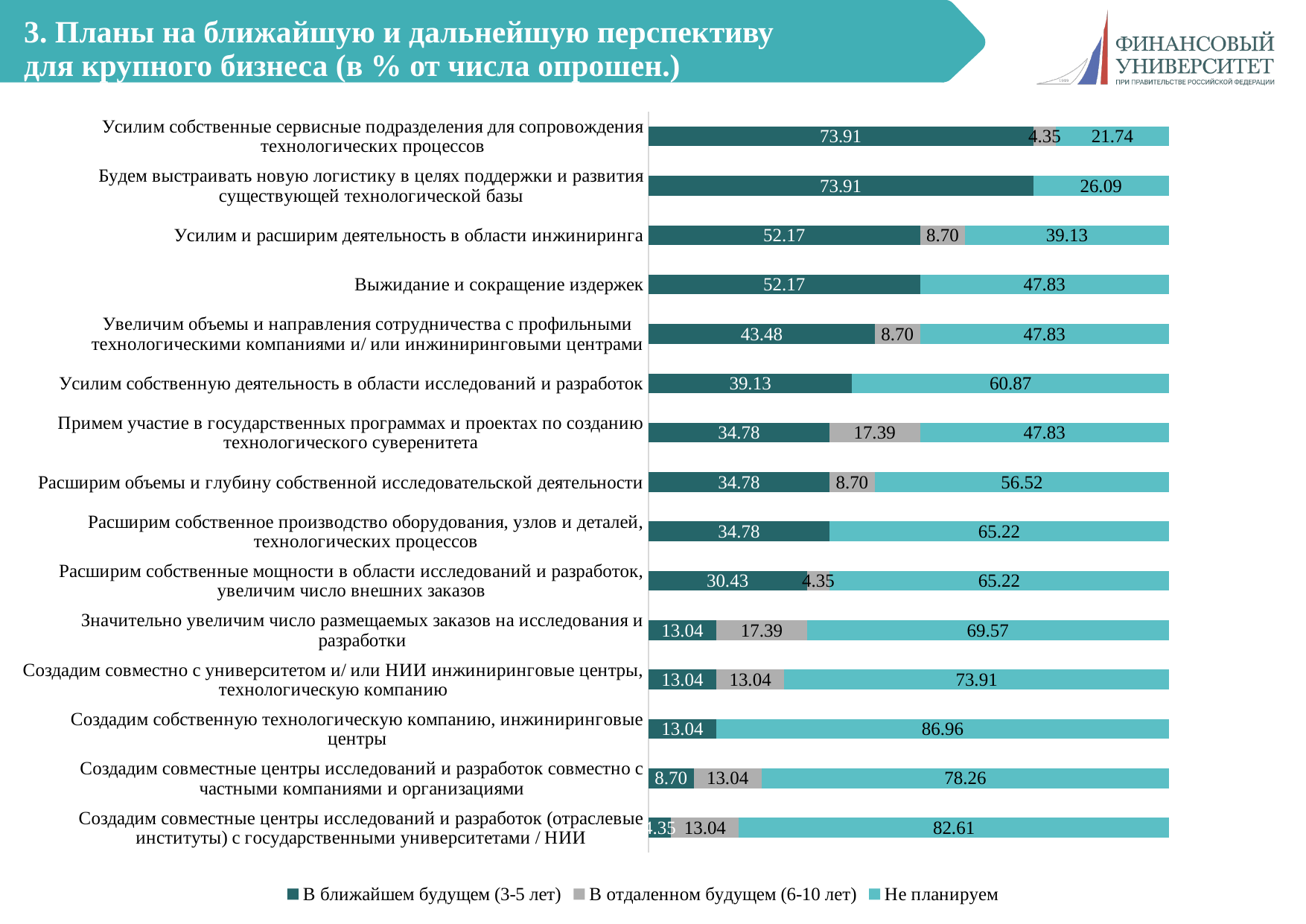
Which legend entry is shown in the lightest (turquoise) colour? Не планируем What is the value of "В ближайшем будущем (3-5 лет)" for "Выжидание и сокращение издержек"? 52.17 What kind of chart is shown on the slide? Stacked bar chart What is the value of "В отдаленном будущем (6-10 лет)" for "Примем участие в государственных программах и проектах по созданию технологического суверенитета"? 17.39 Which is larger: the "Не планируем" value for "Усилим собственную деятельность в области исследований и разработок" or for "Расширим объемы и глубину собственной исследовательской деятельности"? Усилим собственную деятельность в области исследований и разработок What is the difference between the "Не планируем" values for "Выжидание и сокращение издержек" and "Усилим и расширим деятельность в области инжиниринга"? 8.70 How many categories (plans) are plotted in the chart? 15 Which category has the lowest value for "В ближайшем будущем (3-5 лет)"? Создадим совместные центры исследований и разработок (отраслевые институты) с государственными университетами / НИИ Which category has the highest value for "Не планируем"? Создадим собственную технологическую компанию, инжиниринговые центры How many series does the legend list? 3 What is the total of the stacked bar for "Усилим и расширим деятельность в области инжиниринга"? 100 What is the value of "Не планируем" for "Усилим собственную деятельность в области исследований и разработок"? 60.87